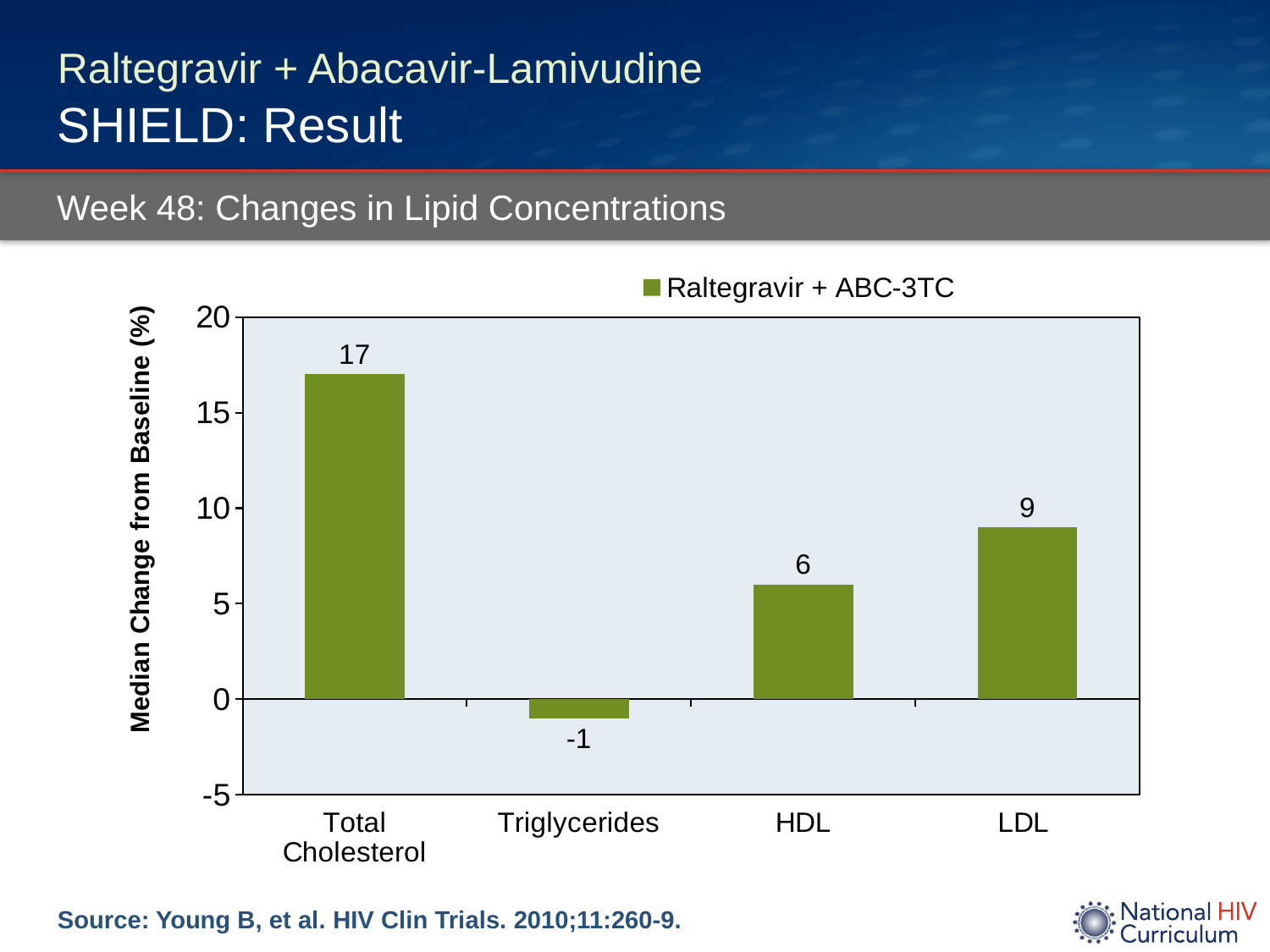
What is the difference between the median change for Total Cholesterol and LDL? 8 What is the median change from baseline for LDL? 9 Is the value for Total Cholesterol greater or less than 15? greater Which has a larger median change from baseline, HDL or LDL? LDL What type of chart is shown on the slide? Bar chart What is the median change from baseline for HDL? 6 Which lipid category has the lowest median change from baseline? Triglycerides What is the median change from baseline for Triglycerides? -1 How many lipid categories are shown on the x axis? 4 What is the median change from baseline for Total Cholesterol? 17 What series does the legend list? Raltegravir + ABC-3TC Which lipid category has the highest median change from baseline? Total Cholesterol